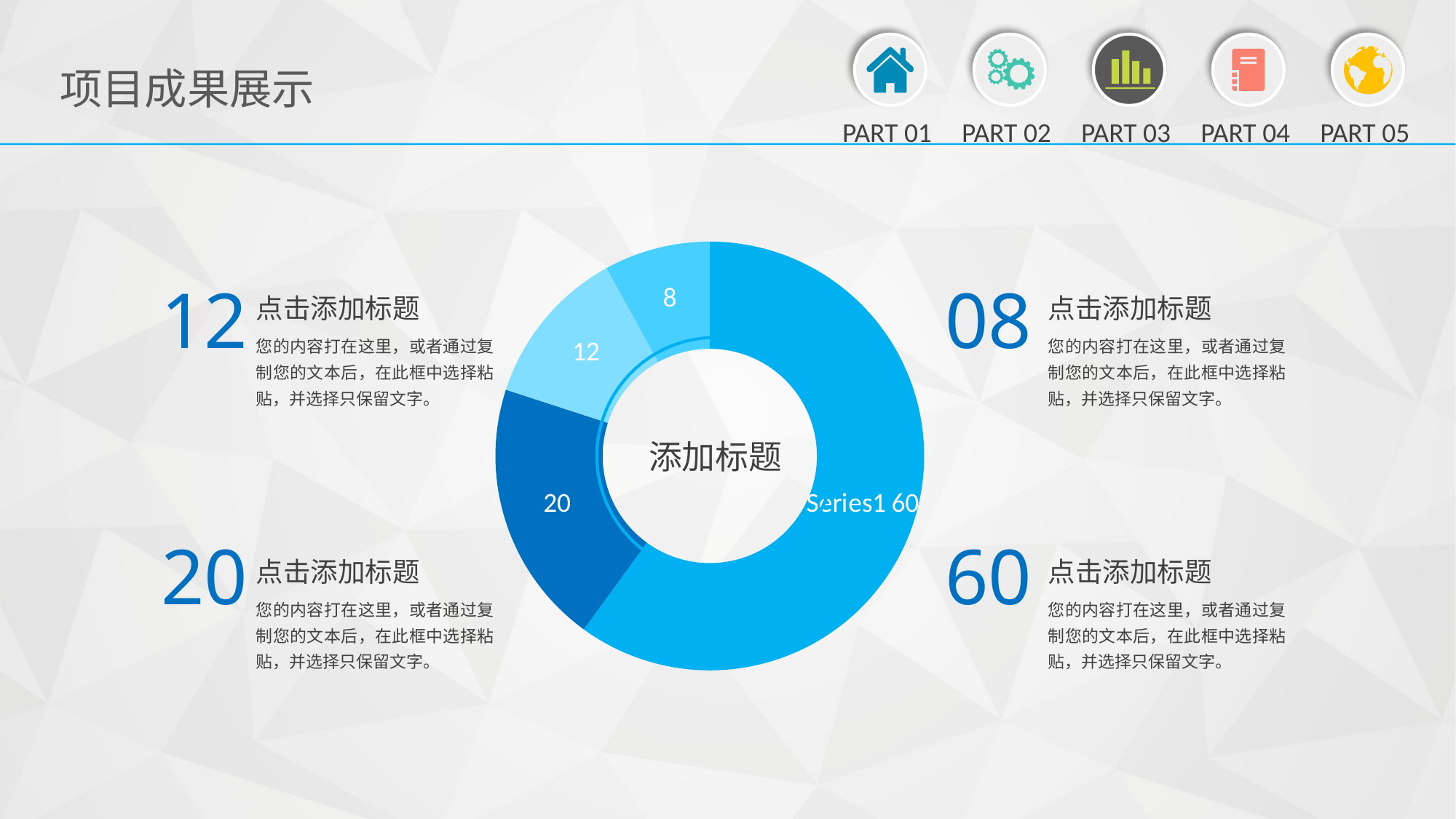
What is the value of the dark blue slice on the left of the doughnut chart? 20 What kind of chart is shown on the slide? doughnut chart What is the total of all slice values on the doughnut chart? 100 What is the difference between the largest and smallest slice values on the doughnut chart? 52 How many slices does the doughnut chart have? 4 Which is larger on the doughnut chart, the slice valued 12 or the slice valued 8? 12 What is the largest value shown on the doughnut chart? 60 What is the value of the slice labelled next to 'Series1' on the doughnut chart? 60 What share of the doughnut chart does the slice valued 60 represent? 60% What is the difference between the slice valued 20 and the slice valued 12 on the doughnut chart? 8 What is the smallest value shown on the doughnut chart? 8 What text is shown in the centre of the doughnut chart? 添加标题